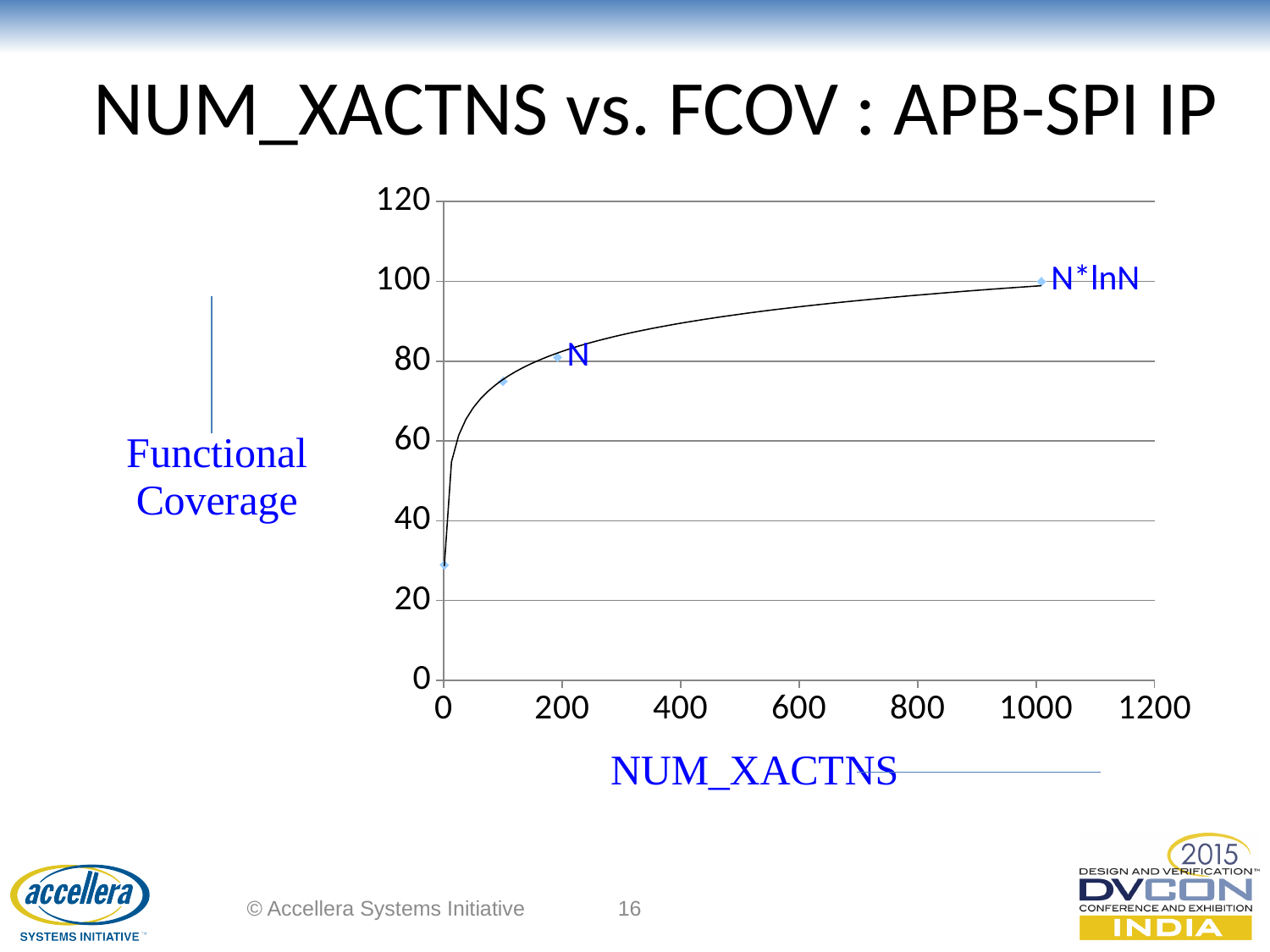
Is the NUM_XACTNS value of the point labelled N greater or less than 400? less Does functional coverage rise or fall as NUM_XACTNS increases along the x axis? rise What is the title of the chart on the slide? NUM_XACTNS vs. FCOV : APB-SPI IP Is the functional coverage value at the point labelled N greater or less than 100? less Is the functional coverage value at the point labelled N greater or less than 60? greater Which labelled point has the higher functional coverage, N or N*lnN? N*lnN What kind of chart is shown on the slide? line chart What is the label of the x axis of the chart? NUM_XACTNS Which labelled point on the curve has the highest functional coverage? N*lnN